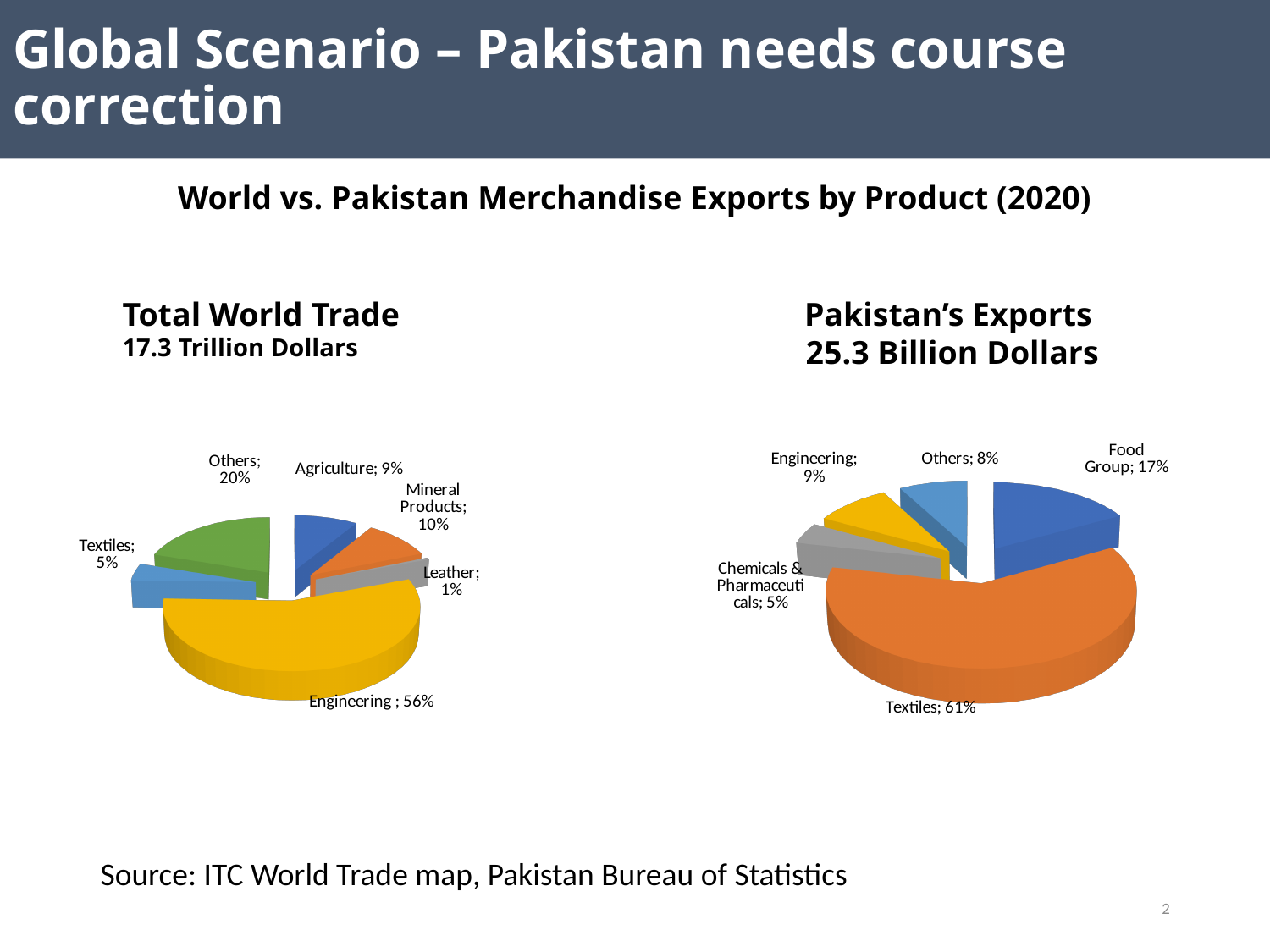
What is the difference between the Textiles share in the Pakistan's Exports chart and the Textiles share in the Total World Trade chart? 56% In the Pakistan's Exports pie chart, which category has the largest share? Textiles In the Total World Trade pie chart, which is larger: the share for Others or the share for Agriculture? Others In the Total World Trade pie chart, what share does Mineral Products have? 10% In the Pakistan's Exports pie chart, what share does Textiles have? 61% What type of chart is used for Total World Trade? Pie chart In the Pakistan's Exports pie chart, what share does Food Group have? 17% In the Total World Trade pie chart, which category has the smallest share? Leather In the Pakistan's Exports pie chart, which category has the smallest share? Chemicals & Pharmaceuticals How many categories are shown in the Pakistan's Exports pie chart? 5 In the Total World Trade pie chart, what share does Engineering have? 56% How many categories are shown in the Total World Trade pie chart? 6